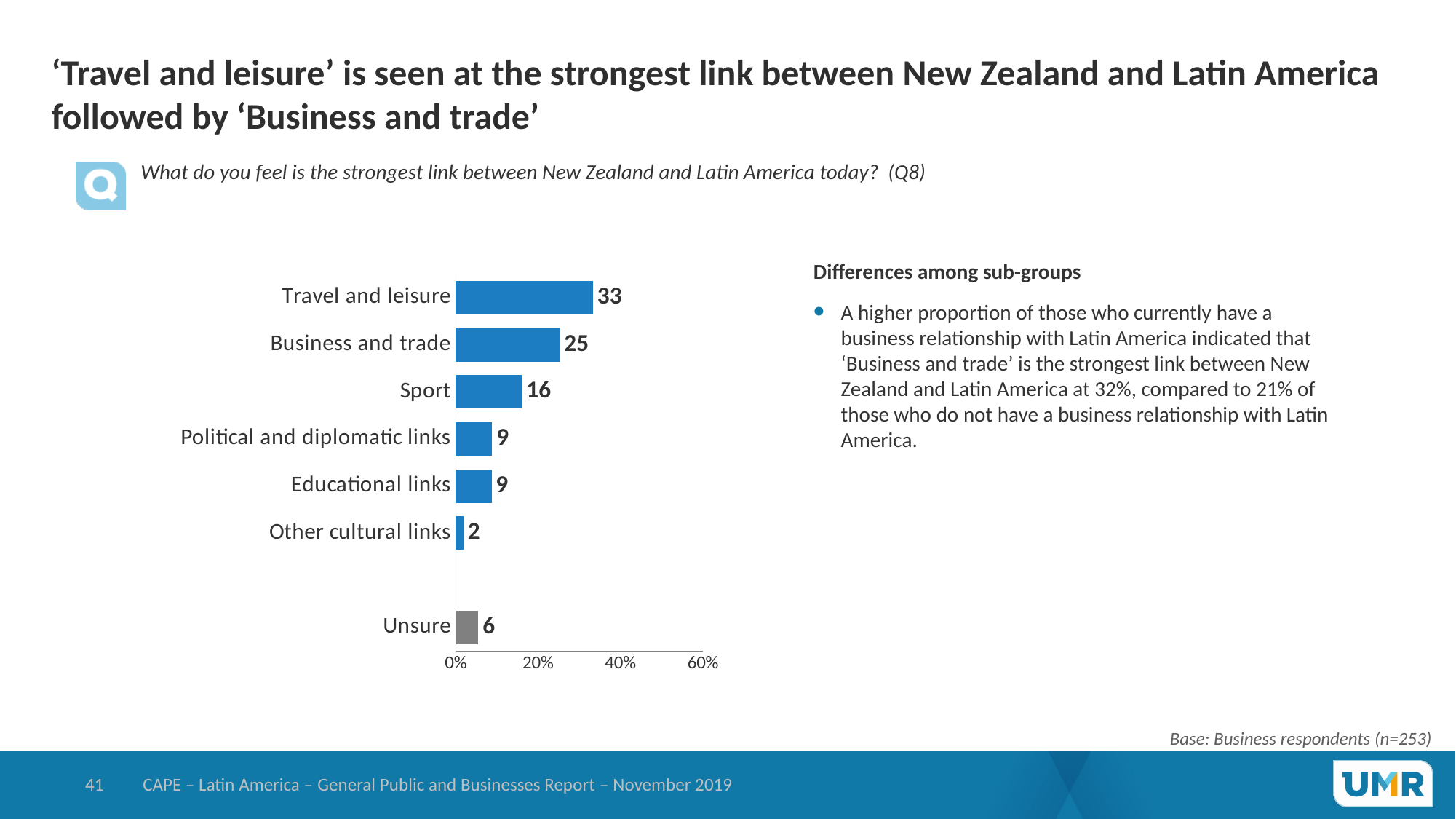
What is the value for 'Sport'? 16 Which category has the lowest value? Other cultural links Which bar is shown in grey rather than blue? Unsure What is the value for 'Unsure'? 6 What kind of chart is shown on the slide? Bar chart Is the value for 'Travel and leisure' greater or less than 40%? less How many categories are shown in the chart? 7 Which category has the highest value? Travel and leisure What is the value for 'Travel and leisure'? 33 What is the difference between the values for 'Travel and leisure' and 'Business and trade'? 8 What is the value for 'Business and trade'? 25 Which is larger, the value for 'Sport' or the value for 'Educational links'? Sport